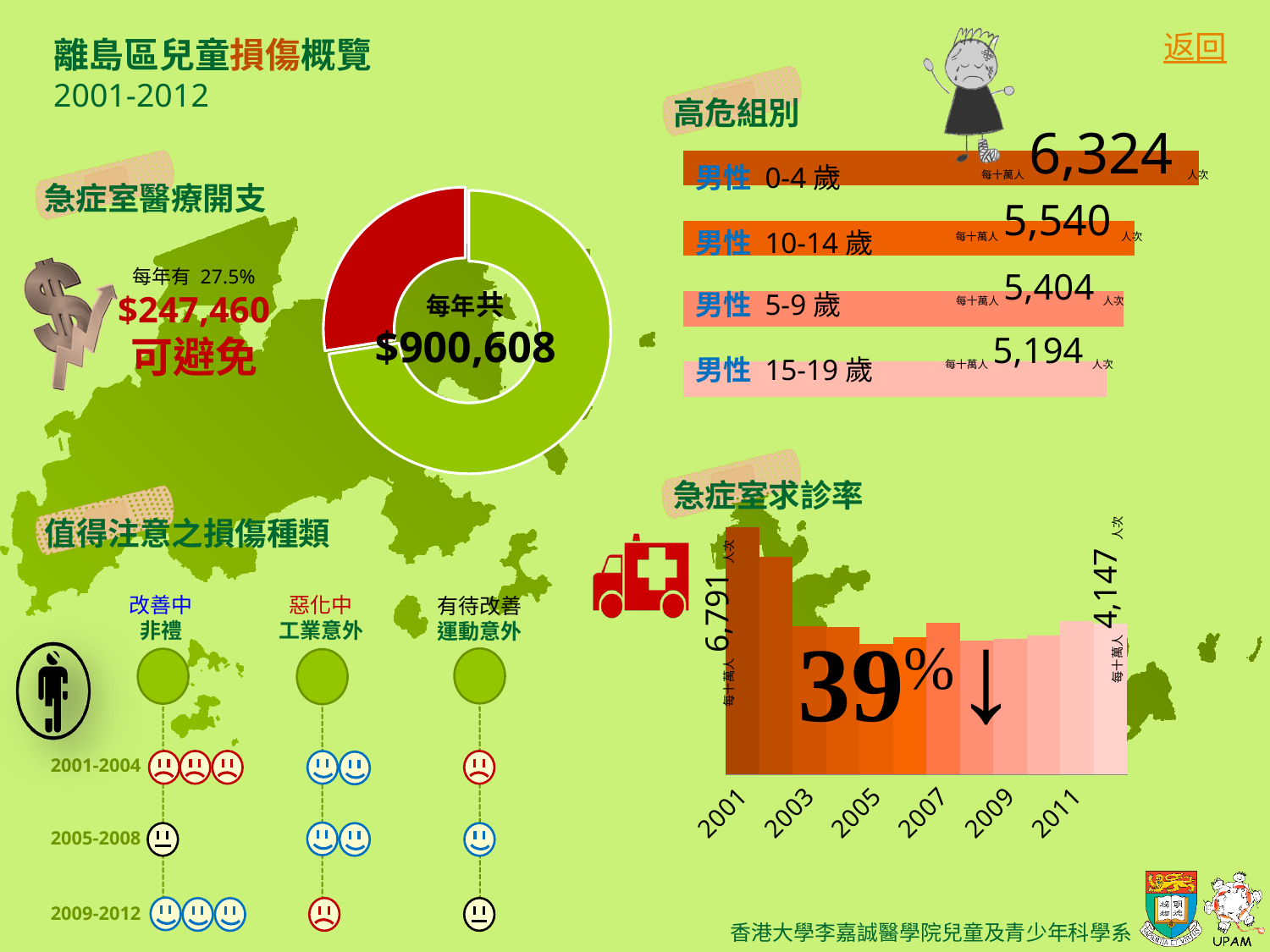
How many groups are shown in the 高危組別 chart? 4 In the 高危組別 chart, which group has the highest value? 男性 0-4 歲 In the 急症室求診率 chart, what is the value for 2001? 6,791 In the 急症室求診率 chart, what is the difference between the 2001 value (6,791) and the 2012 value (4,147)? 2,644 In the 高危組別 chart, what is the value for 男性 15-19 歲? 5,194 In the 急症室醫療開支 donut chart, what share of the total is labelled as avoidable (可避免)? 27.5% In the 急症室求診率 chart, do the values rise or fall from 2001 to 2012? fall In the 高危組別 chart, what is the difference between the values for 男性 0-4 歲 and 男性 15-19 歲? 1,130 In the 高危組別 chart, which group has the lowest value? 男性 15-19 歲 What kind of chart is the 高危組別 chart? bar chart In the 高危組別 chart, what is the value for 男性 0-4 歲? 6,324 In the 高危組別 chart, which is larger: the value for 男性 10-14 歲 or 男性 5-9 歲? 男性 10-14 歲